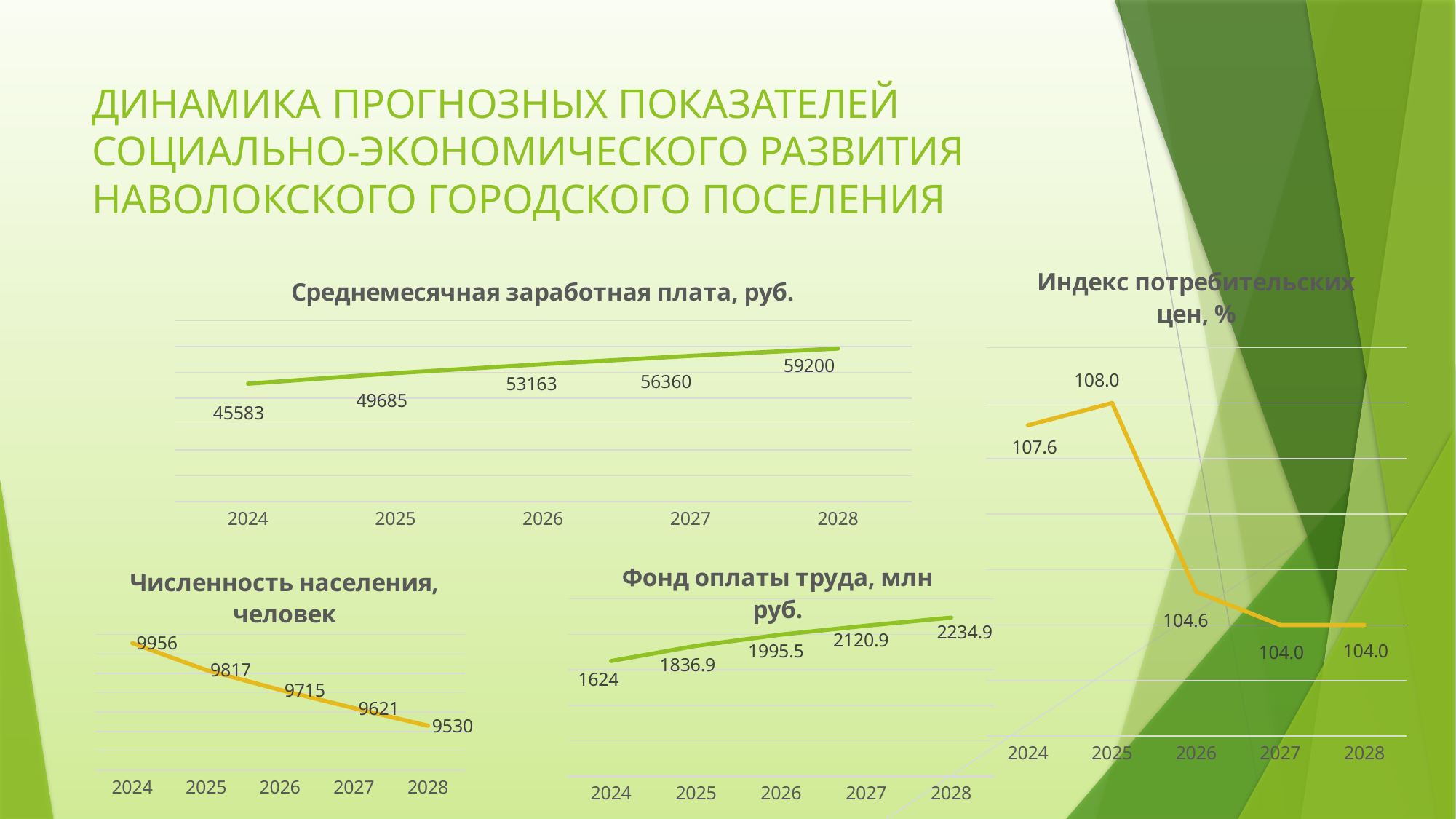
In the chart 'Фонд оплаты труда, млн руб.', what is the value for 2025? 1836.9 In the chart 'Численность населения, человек', what is the value for 2027? 9621 In the chart 'Среднемесячная заработная плата, руб.', what is the difference between the 2028 and 2024 values? 13617 How many charts are shown on the slide? 4 In the chart 'Фонд оплаты труда, млн руб.', which is larger, the value for 2027 or the value for 2026? 2027 In the chart 'Индекс потребительских цен, %', what is the value for 2026? 104.6 In the chart 'Численность населения, человек', do the values rise or fall from 2024 to 2028? fall In the chart 'Среднемесячная заработная плата, руб.', do the values rise or fall from 2024 to 2028? rise In the chart 'Численность населения, человек', which year has the lowest value? 2028 In the chart 'Индекс потребительских цен, %', which year has the highest value? 2025 In the chart 'Индекс потребительских цен, %', what is the difference between the 2025 and 2024 values? 0.4 In the chart 'Среднемесячная заработная плата, руб.', what is the value for 2026? 53163